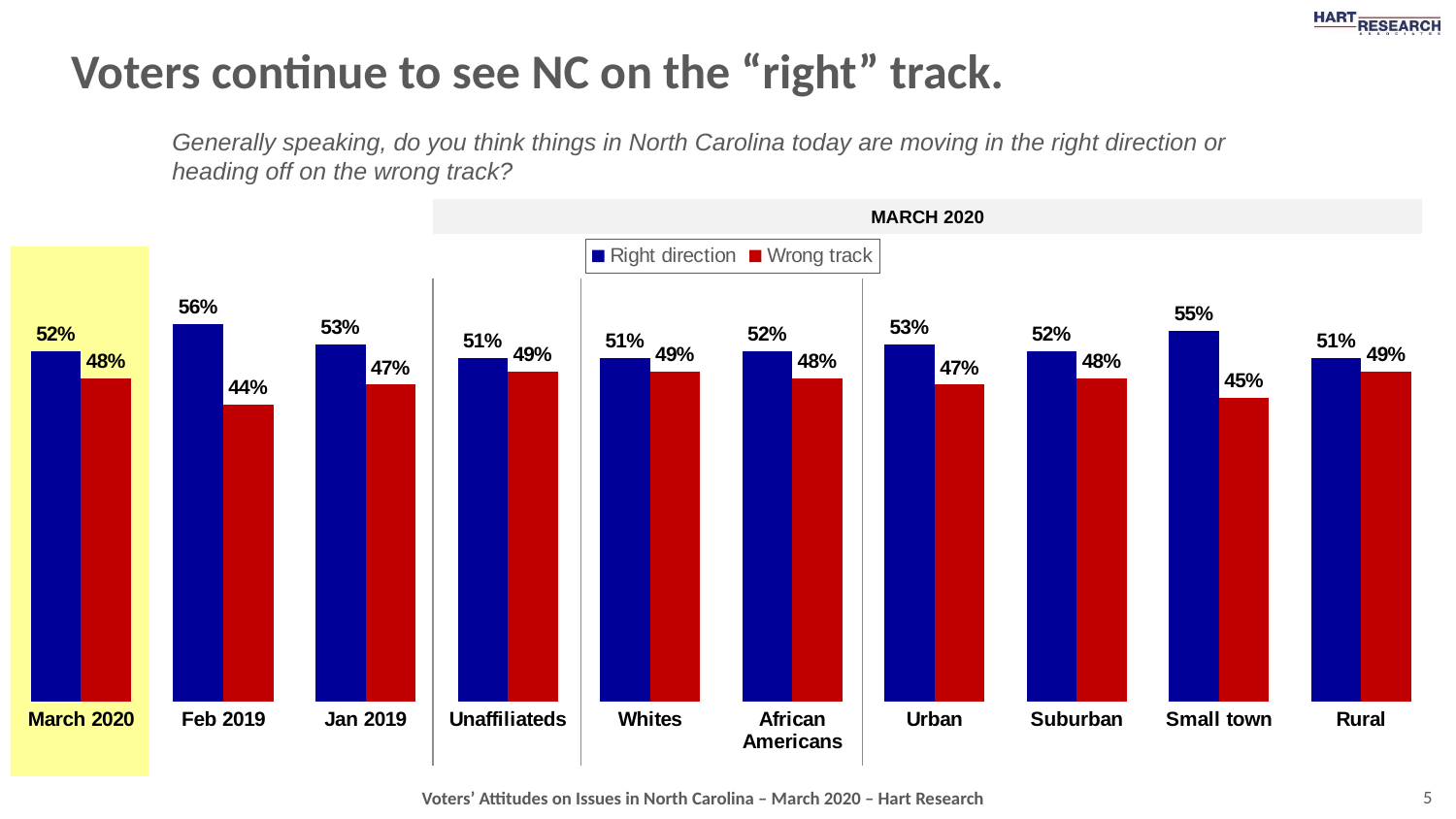
How many categories are shown along the x axis? 10 What kind of chart is shown on the slide? Bar chart Which is larger for Small town voters, "Right direction" or "Wrong track"? Right direction Which colour represents "Wrong track" in the chart? Red How many series does the legend list? 2 What percentage of voters said "Right direction" in March 2020? 52% Which category has the lowest "Wrong track" value? Feb 2019 What is the "Right direction" value for Small town voters? 55% What is the "Wrong track" value for Urban voters? 47% What is the difference between "Right direction" and "Wrong track" for Feb 2019? 12 percentage points What is the "Wrong track" value for Feb 2019? 44% Which category has the highest "Right direction" value? Feb 2019